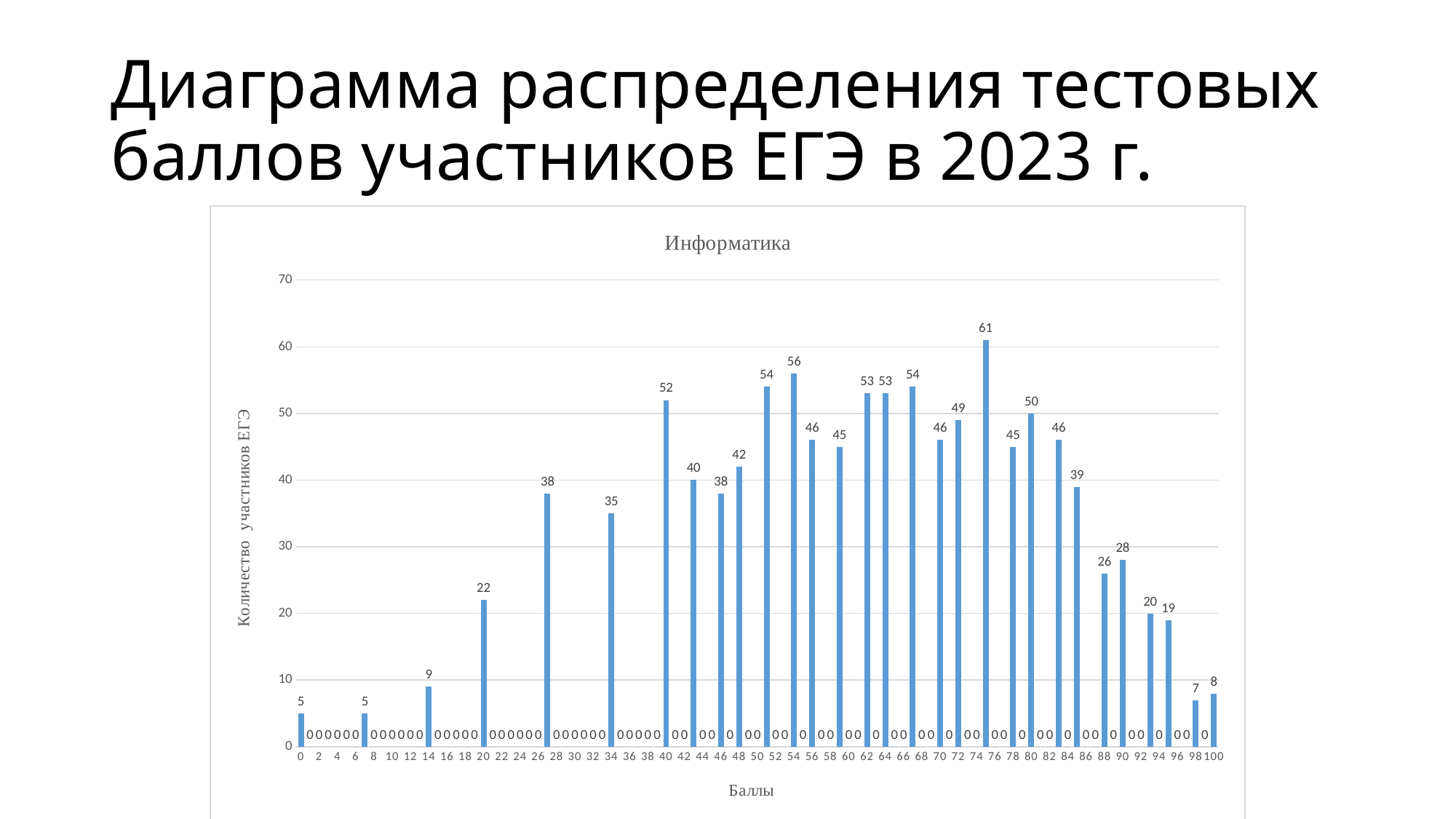
What is the number of participants for a score of 80? 50 What is the difference between the number of participants with a score of 100 and those with a score of 98? 1 How many participants scored 100 points according to the chart? 8 What is the title of the chart? Информатика What is the number of participants for a score of 90? 28 How many participants scored 0 points according to the chart? 5 What kind of chart is shown on the slide? bar chart What is the highest number of participants shown for any score in the chart? 61 What is the difference between the number of participants with a score of 20 and those with a score of 14? 13 What is the number of participants for a score of 20? 22 What is the number of participants for a score of 40? 52 Which score has more participants: 40 or 80? 40